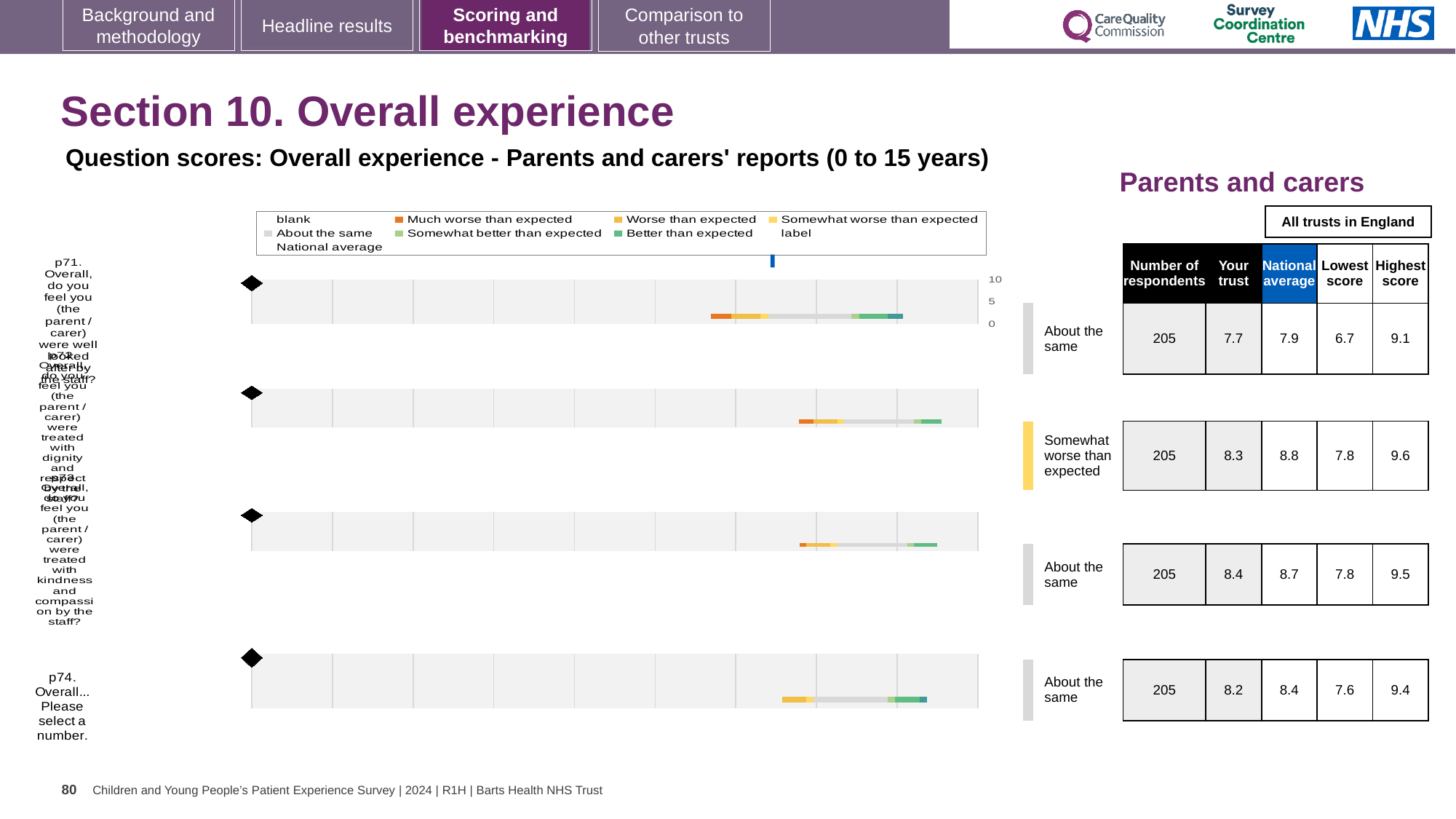
What is the number of respondents shown for question p71? 205 What is the lowest score shown for question p72? 7.8 What is the national average score for question p73? 8.7 Which question has the lowest 'Your trust' score? p71 What is the highest score shown for question p74? 9.4 What kind of chart is used to show the question scores on this slide? bar chart For question p72, which is larger: the 'Your trust' score or the national average? National average What benchmark category label is shown for question p72? Somewhat worse than expected What is the difference between the national average and the 'Your trust' score for question p71? 0.2 How many questions (rows) are plotted in the chart? 4 Which question has the highest 'Your trust' score? p73 What is the 'Your trust' score for question p72? 8.3